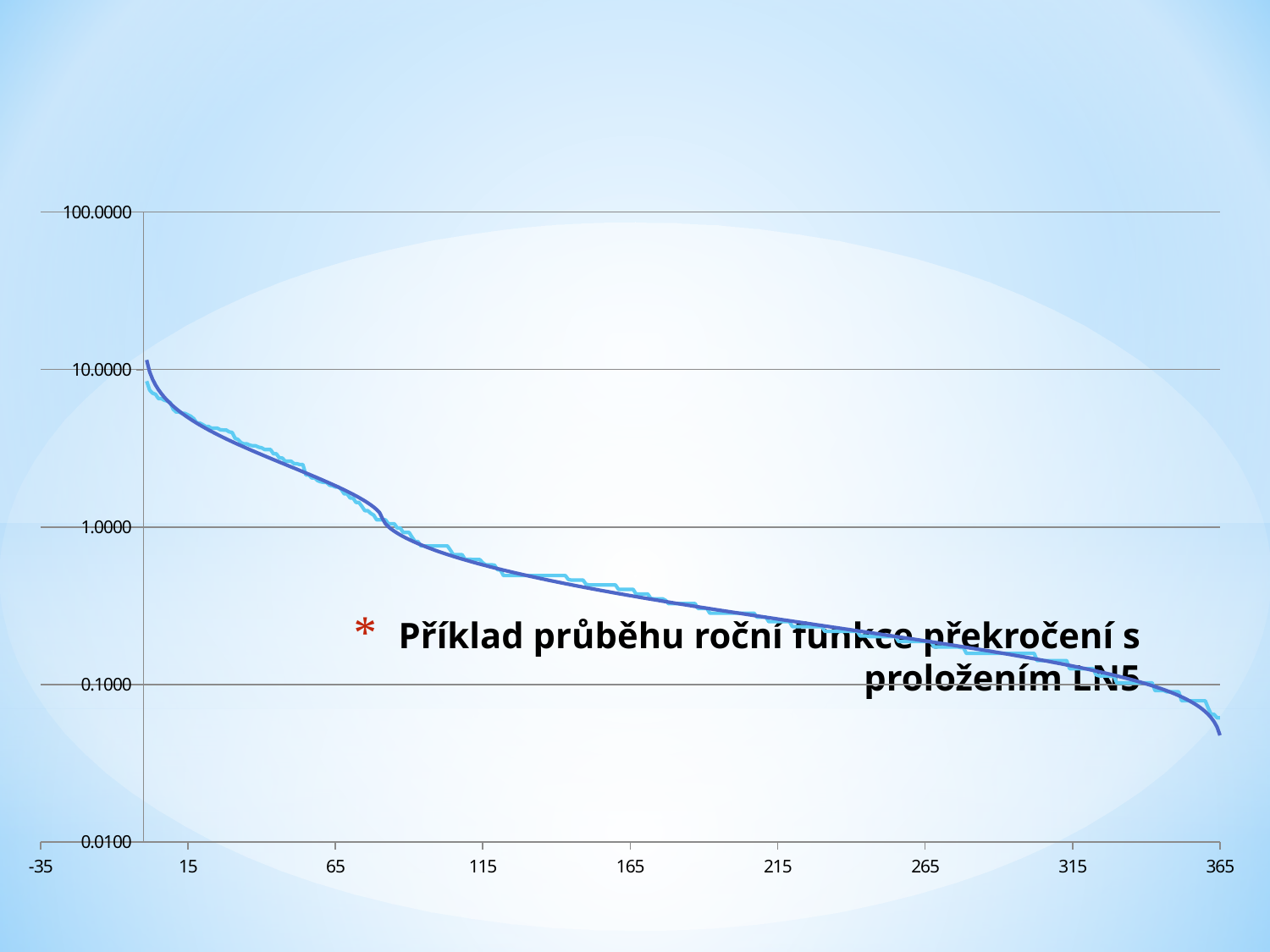
What kind of chart is shown on the slide? line chart Is the plotted value at x = 15 greater or less than 10.0000? less Is the plotted value at x = 165 greater or less than 1.0000? less What is the highest value labelled on the y axis? 100.0000 Is the plotted value at x = 65 greater or less than 1.0000? greater Do the plotted values rise or fall as the x axis increases from 15 to 365? fall How many lines are plotted on the chart? 2 What is the largest value labelled on the x axis? 365